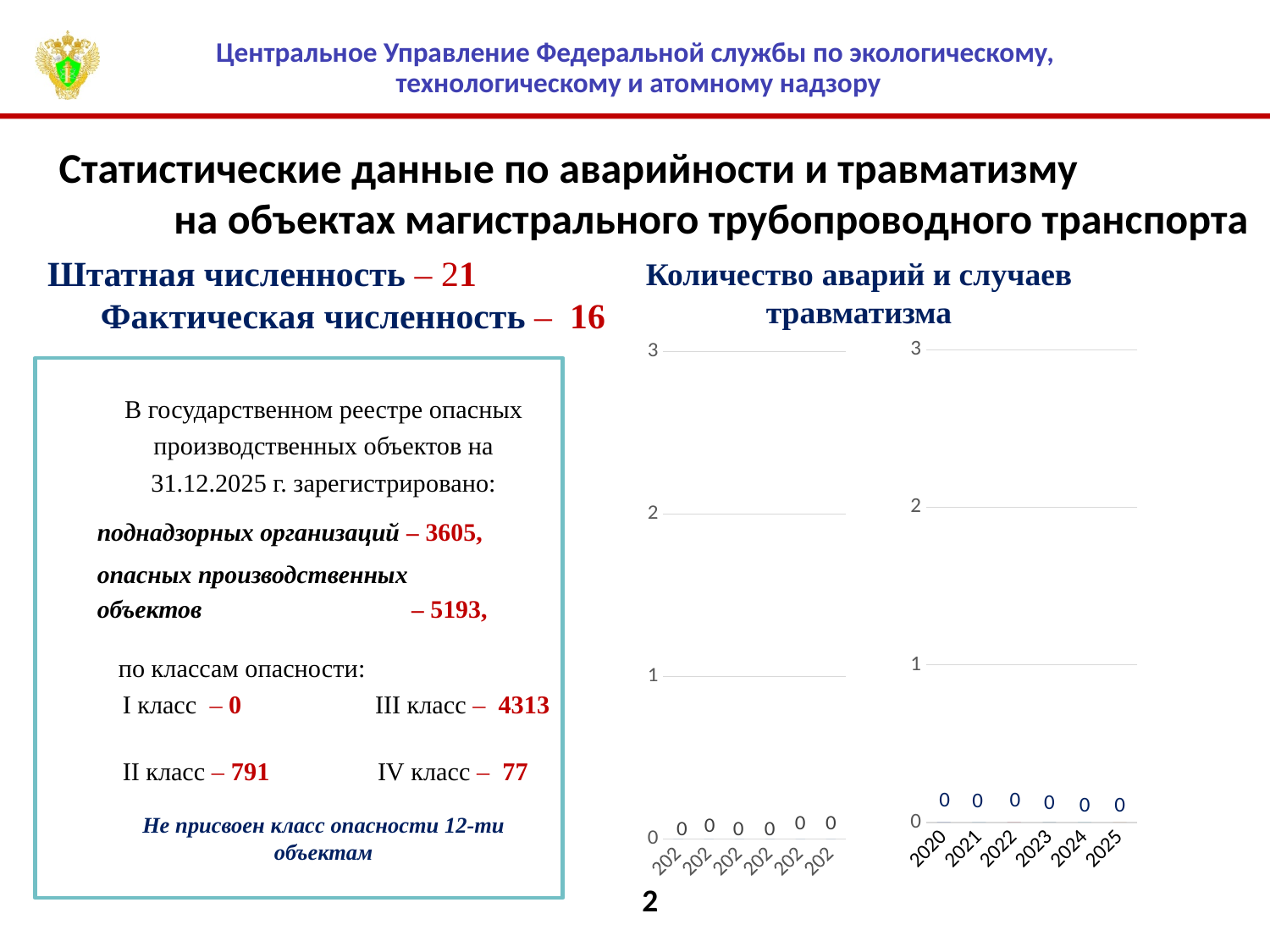
On the right chart (years 2020–2025), what is the highest tick value shown on the vertical axis? 3 What is the title above the two charts on the right side of the slide? Количество аварий и случаев травматизма On the right chart (years 2020–2025), how many years are shown on the x axis? 6 On the right chart (years 2020–2025), is the value for 2022 greater or less than 1? less On the right chart (years 2020–2025), what is the value for 2023? 0 On the right chart (years 2020–2025), what is the value for 2025? 0 On the right chart (years 2020–2025), what is the value for 2020? 0 On the right chart (years 2020–2025), what is the difference between the values for 2020 and 2025? 0 On the right chart (years 2020–2025), do the values rise, fall, or stay the same from 2020 to 2025? stay the same On the left chart, what value is printed on every data label? 0 On the left chart, how many data points are labelled? 6